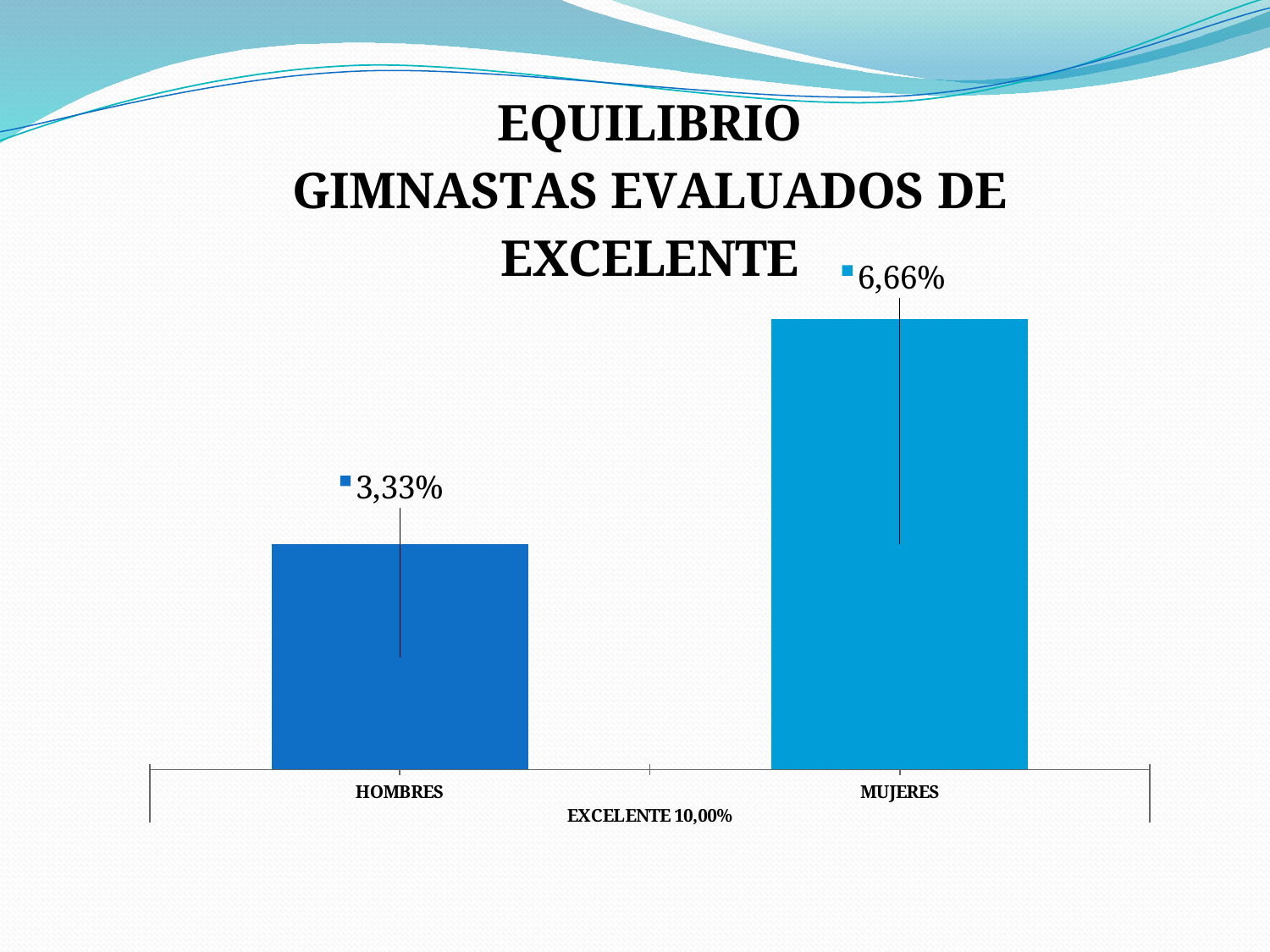
What is the difference between the values for MUJERES and HOMBRES? 3,33% Which category has the highest value? MUJERES What is the value for HOMBRES? 3,33% What is the title of the chart? EQUILIBRIO GIMNASTAS EVALUADOS DE EXCELENTE What kind of chart is shown on the slide? Bar chart How many categories are shown in the chart? 2 Which is larger, the value for HOMBRES or the value for MUJERES? MUJERES What is the value for MUJERES? 6,66% What is the total of the two values shown in the chart? 9,99% What label appears below the category axis? EXCELENTE 10,00% Which category has the lowest value? HOMBRES